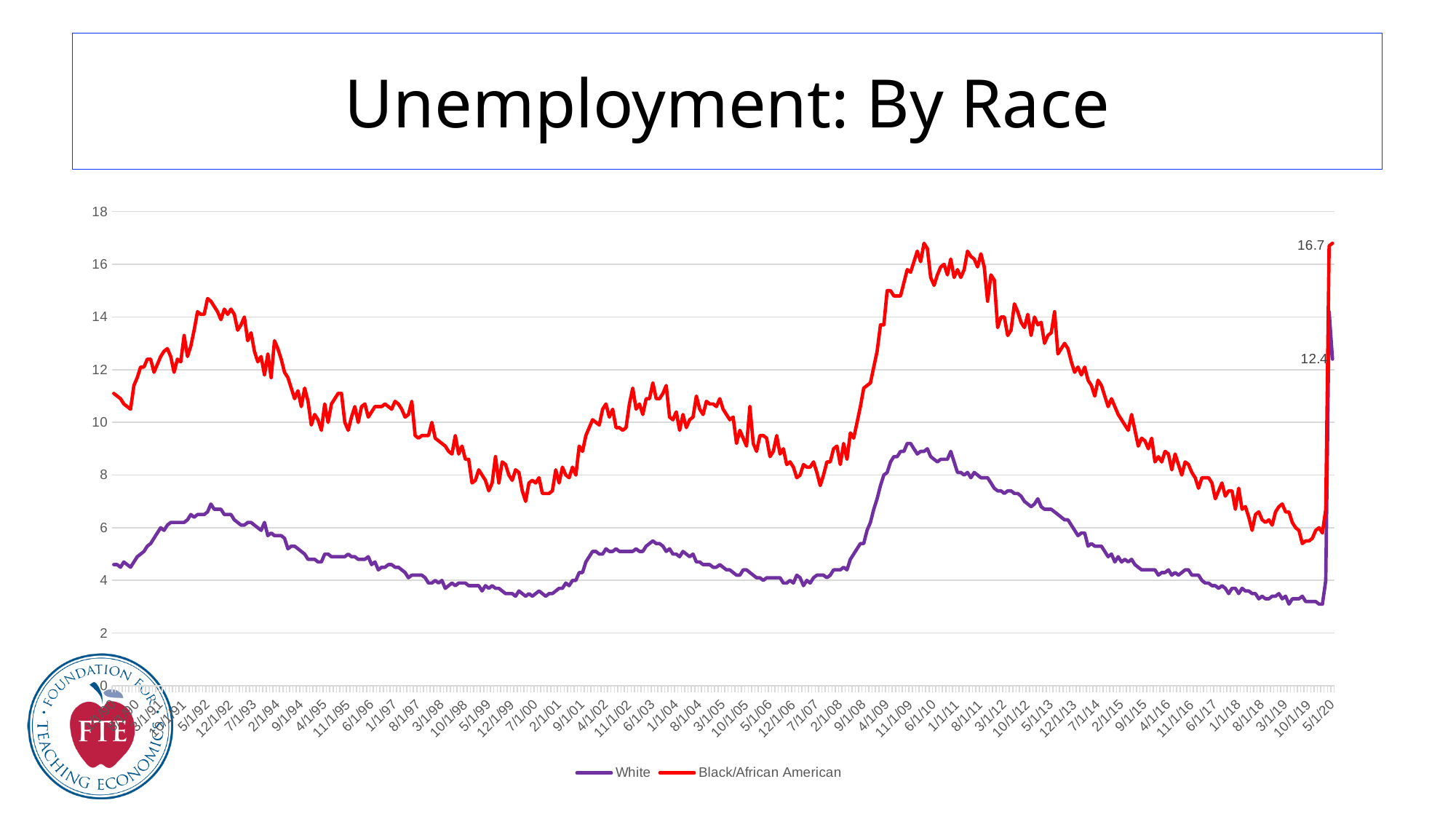
What is the difference between the final labelled values of the Black/African American series (16.7) and the White series (12.4)? 4.3 Between 6/1/10 and 10/1/19, does the Black/African American series generally rise or fall? fall Which series stays above the other across the whole period shown? Black/African American Around 12/1/99, is the Black/African American series greater or less than 10? less At its peak around 2010, is the Black/African American series greater or less than 14? greater How many series does the legend list? 2 What is the title of the chart? Unemployment: By Race What is the labelled value for the White series at the end of the chart (5/1/20)? 12.4 What is the labelled value for the Black/African American series at the end of the chart (5/1/20)? 16.7 What kind of chart is shown on the slide? line chart Which series has the higher value at the end of the chart, White or Black/African American? Black/African American At its peak around 2009-2010, is the White series greater or less than 8? greater